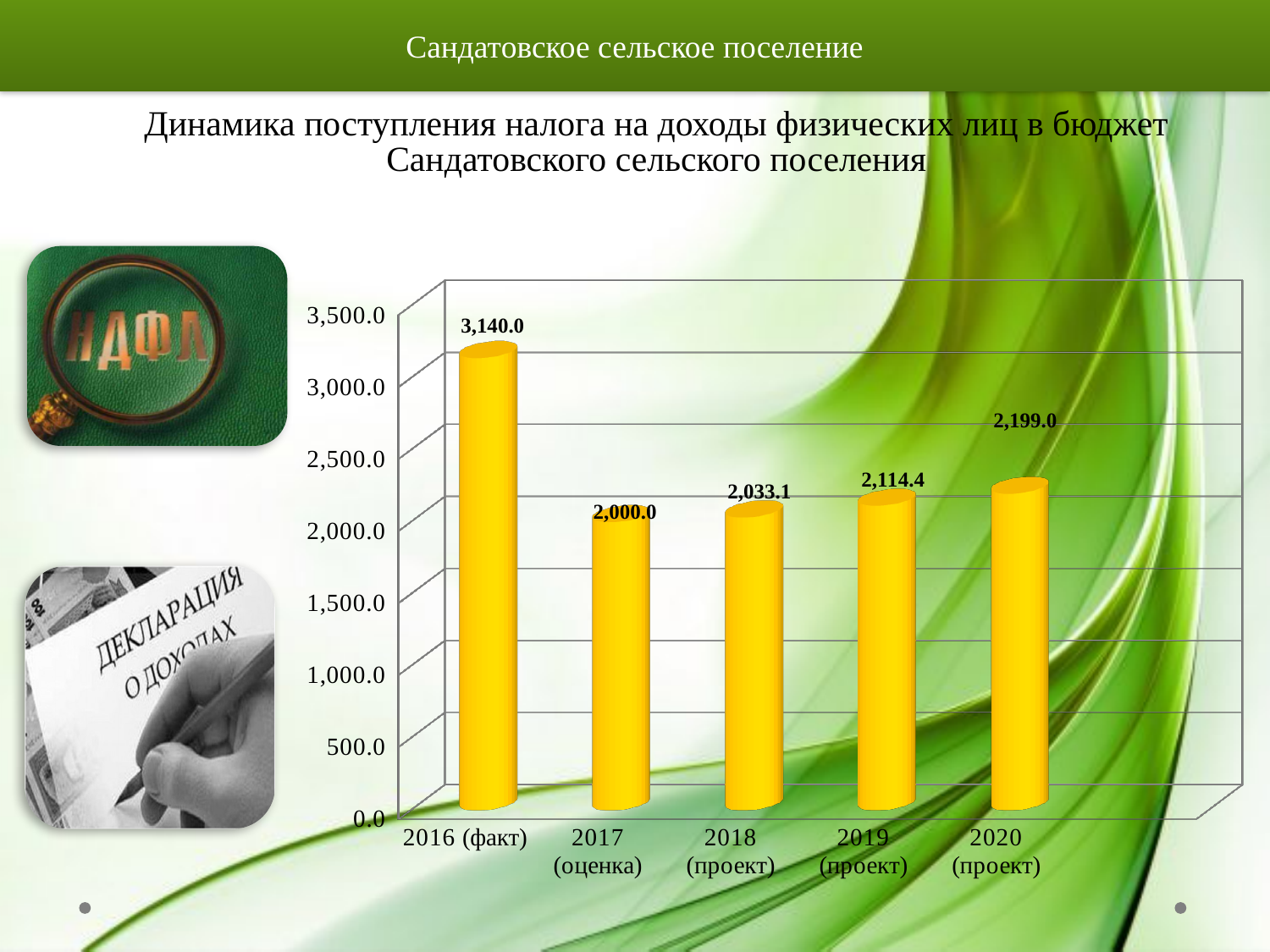
Which is larger, the value for 2019 (проект) or the value for 2018 (проект)? 2019 (проект) What is the value for 2016 (факт)? 3,140.0 From 2017 (оценка) to 2020 (проект), do the values rise or fall? rise What is the value for 2018 (проект)? 2,033.1 How many categories are shown on the x axis? 5 Which category has the highest value? 2016 (факт) What is the difference between the values for 2016 (факт) and 2017 (оценка)? 1,140.0 What is the value for 2020 (проект)? 2,199.0 Which category has the lowest value? 2017 (оценка) What kind of chart is shown on the slide? bar chart Is the value for 2016 (факт) greater or less than 3,000.0? greater What is the difference between the values for 2020 (проект) and 2019 (проект)? 84.6